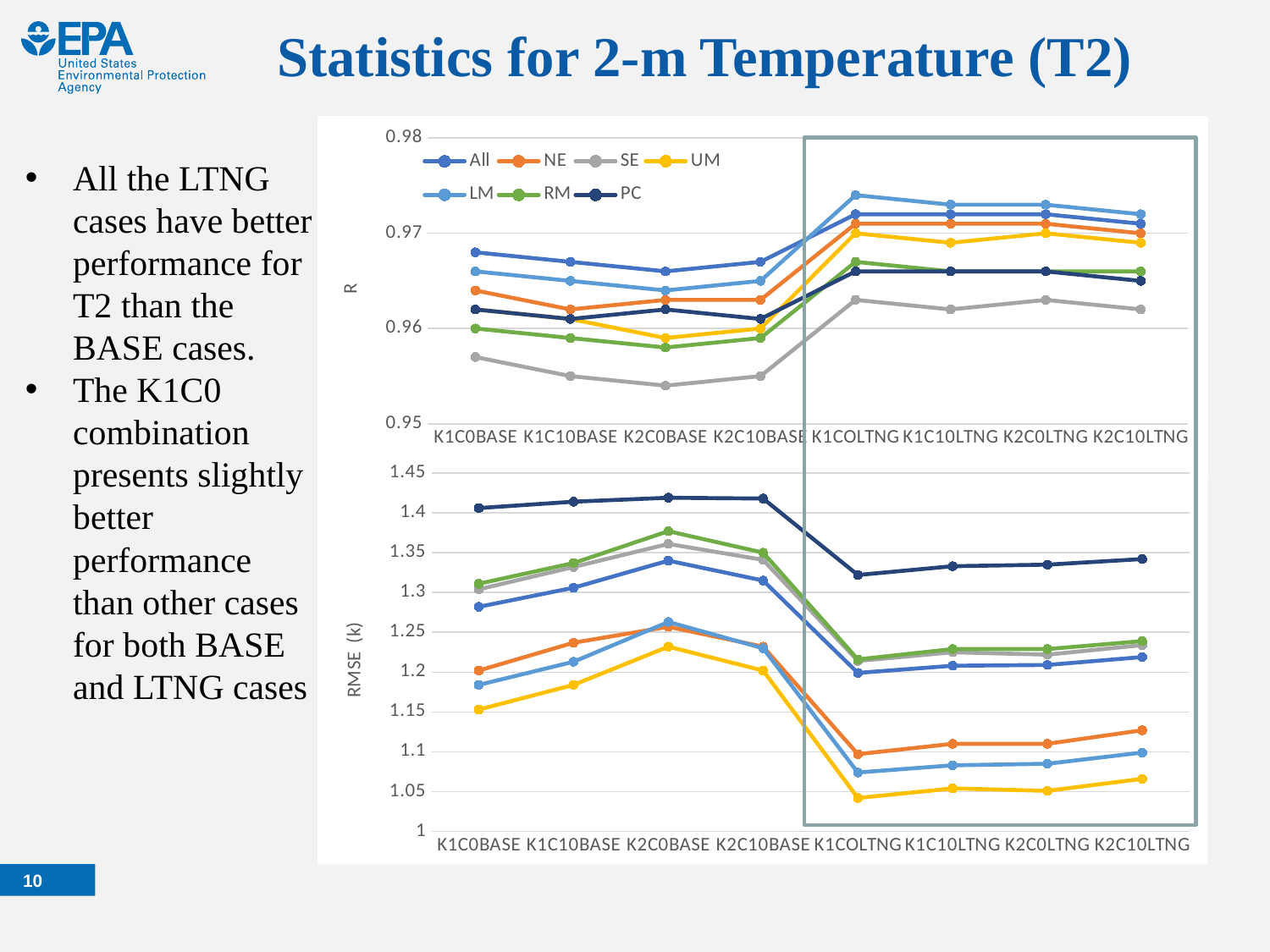
How many categories are shown on the x axis of the bottom chart (RMSE)? 8 What kind of chart is the top chart (R) on the slide? line chart In the top chart (R), which series has the lowest values across all cases? SE In the bottom chart (RMSE), is the value for UM at K1COLTNG greater or less than 1.05? less In the bottom chart, does the PC series rise or fall from K2C10BASE to K1COLTNG? fall In the bottom chart (RMSE), is the value for PC at K1C0BASE greater or less than 1.35? greater In the bottom chart (RMSE), which series has the lowest values across all cases? UM In the top chart (R), is the value for SE at K2C0BASE greater or less than 0.96? less In the bottom chart (RMSE), which is larger at K1C0BASE, PC or UM? PC In the bottom chart (RMSE), which series has the highest values across all cases? PC How many series does the legend of the top chart list? 7